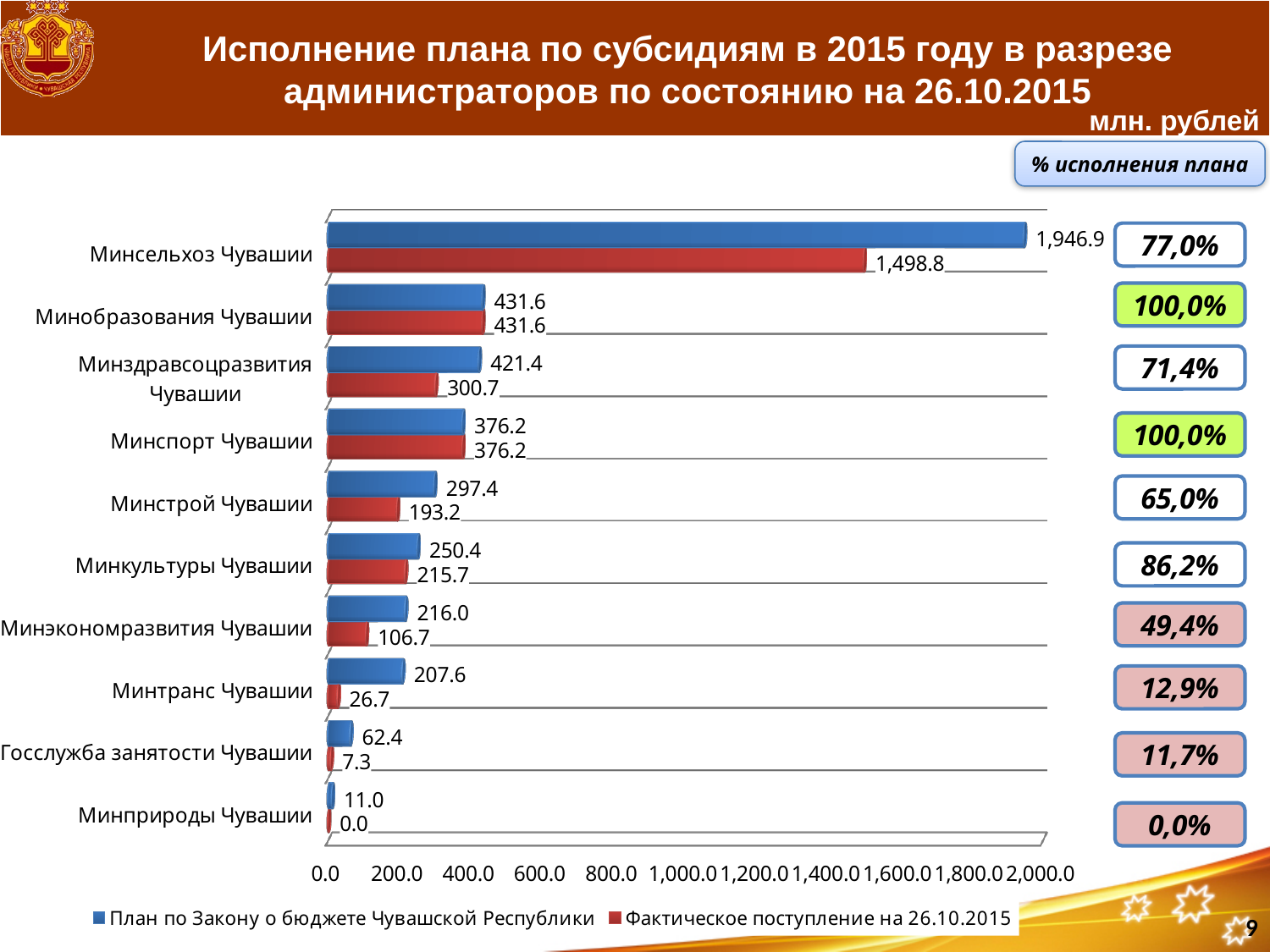
What kind of chart is shown on the slide? Bar chart What is the value of "План по Закону о бюджете Чувашской Республики" for Минсельхоз Чувашии? 1,946.9 How many categories (administrators) are shown on the chart? 10 What is the value of "Фактическое поступление на 26.10.2015" for Минстрой Чувашии? 193.2 Which category has the highest value for "План по Закону о бюджете Чувашской Республики"? Минсельхоз Чувашии Is the plan value for Минкультуры Чувашии greater or less than 200.0? greater How many series does the legend list? 2 Which category has the lowest value for "Фактическое поступление на 26.10.2015"? Минприроды Чувашии Which is larger for Минэкономразвития Чувашии: the plan value or the actual value? The plan value (216.0) What is the difference between the plan value and the actual value for Минздравсоцразвития Чувашии? 120.7 What is the value of "Фактическое поступление на 26.10.2015" for Минтранс Чувашии? 26.7 Which colour represents "Фактическое поступление на 26.10.2015" in the chart? Red